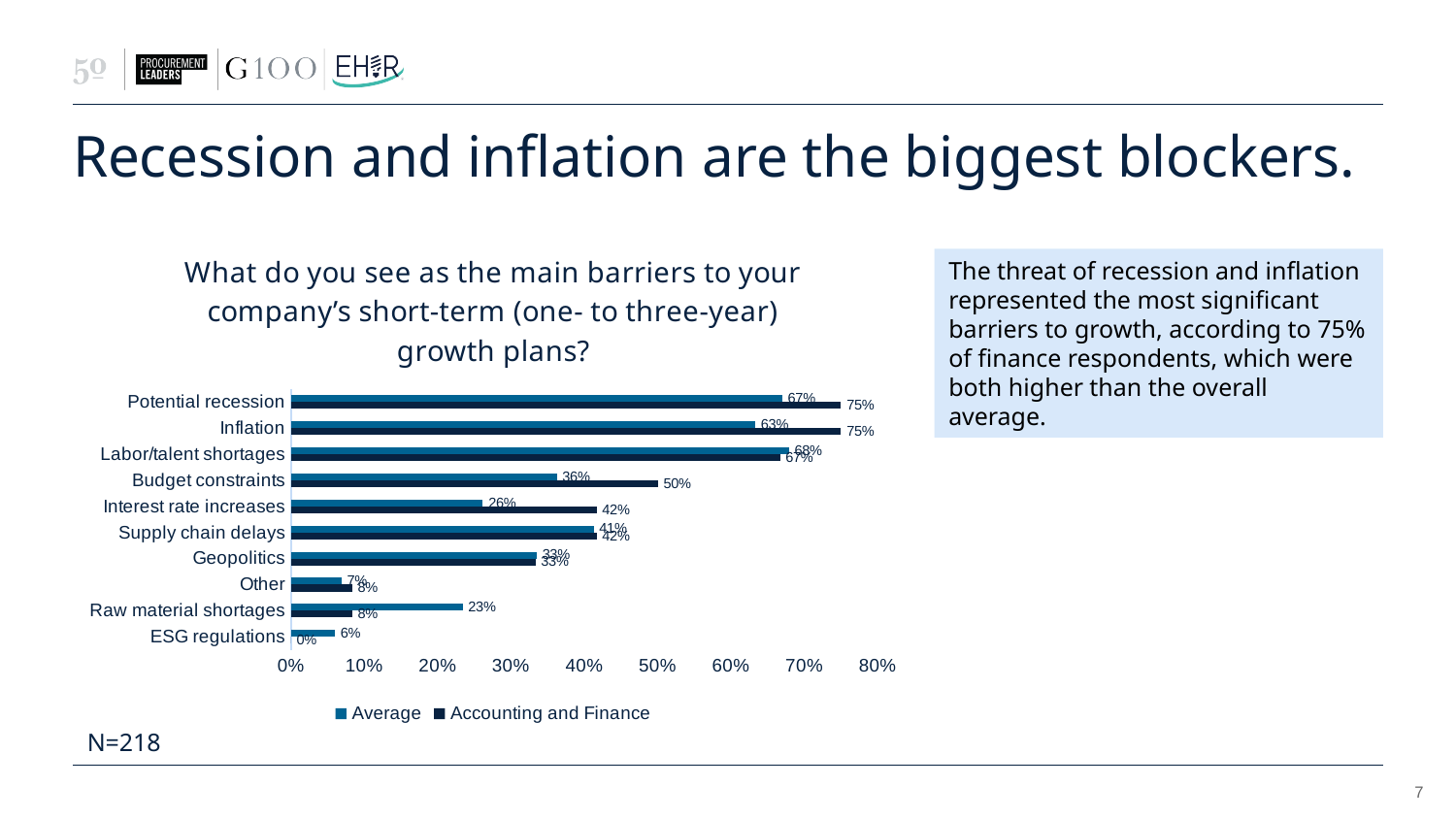
For Budget constraints, how much higher is the Accounting and Finance value than the Average value? 14 percentage points What is the Accounting and Finance value for Budget constraints? 50% How many barrier categories are plotted on the chart? 10 What kind of chart is shown on the slide? Bar chart What is the Accounting and Finance value for Interest rate increases? 42% Is the Average value for Inflation greater or less than 60%? greater What is the Average value for Potential recession? 67% What is the Average value for Raw material shortages? 23% Which category has the lowest Accounting and Finance value? ESG regulations For Raw material shortages, how much higher is the Average value than the Accounting and Finance value? 15 percentage points How many series does the chart's legend list? 2 For Interest rate increases, which series has the larger value, Average or Accounting and Finance? Accounting and Finance